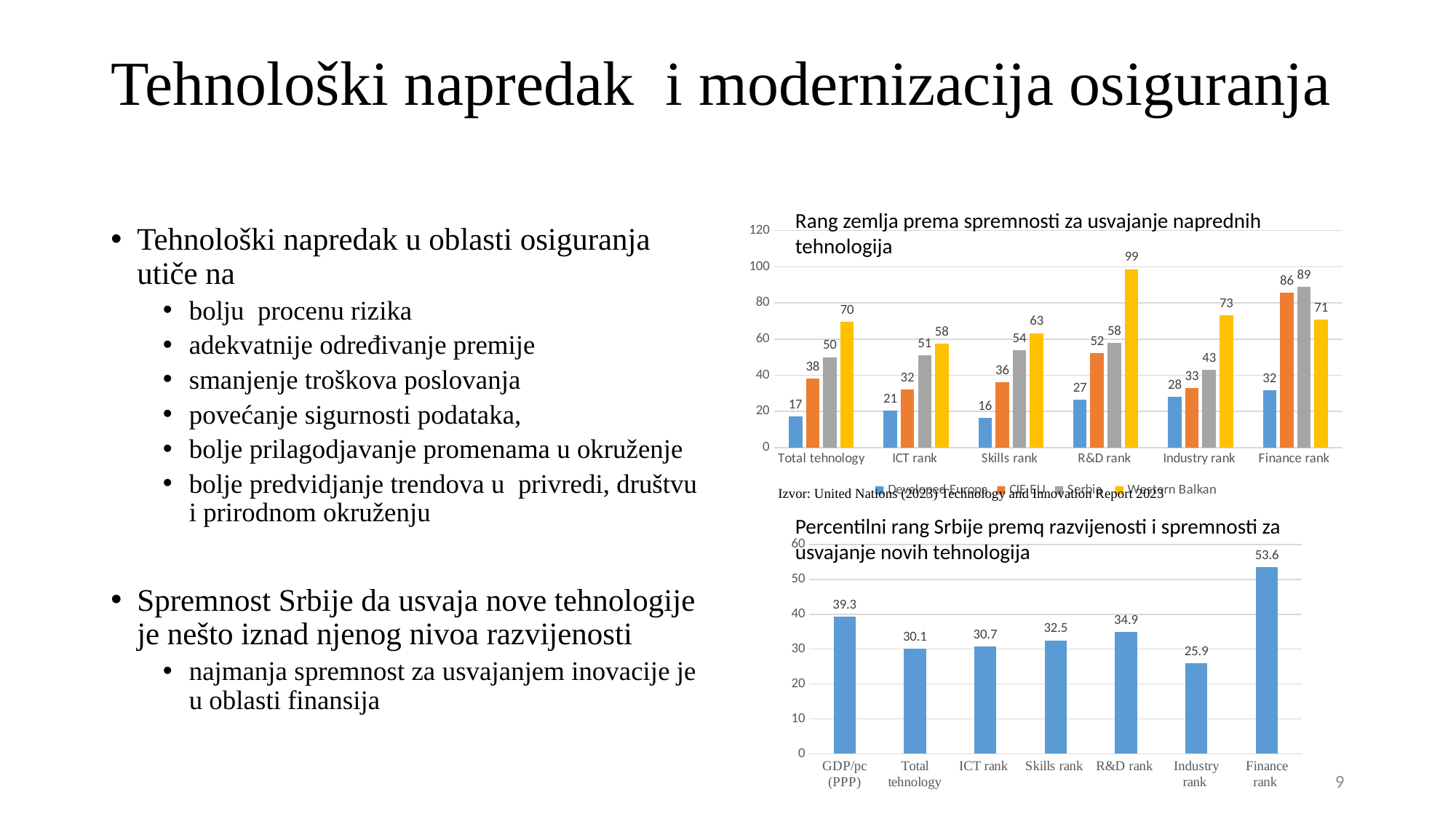
In the top chart (Rang zemlja prema spremnosti), what is the value of the yellow bar for R&D rank? 99 In the bottom chart (Percentilni rang Srbije), what is the difference between the values for Finance rank and Industry rank? 27.7 In the top chart (Rang zemlja prema spremnosti), what is the difference between the gray bar and the blue bar for Finance rank? 57 What type of chart is the bottom chart (Percentilni rang Srbije)? bar chart In the top chart (Rang zemlja prema spremnosti), how many series are plotted per category? 4 In the bottom chart (Percentilni rang Srbije), what is the value for Finance rank? 53.6 In the top chart (Rang zemlja prema spremnosti), which is larger for Finance rank: the gray bar or the yellow bar? the gray bar In the top chart (Rang zemlja prema spremnosti), what is the value of the blue bar for Skills rank? 16 In the bottom chart (Percentilni rang Srbije), which category has the lowest value? Industry rank In the bottom chart (Percentilni rang Srbije), which category has the highest value? Finance rank In the bottom chart (Percentilni rang Srbije), how many categories are shown? 7 In the bottom chart (Percentilni rang Srbije), what is the value for GDP/pc (PPP)? 39.3